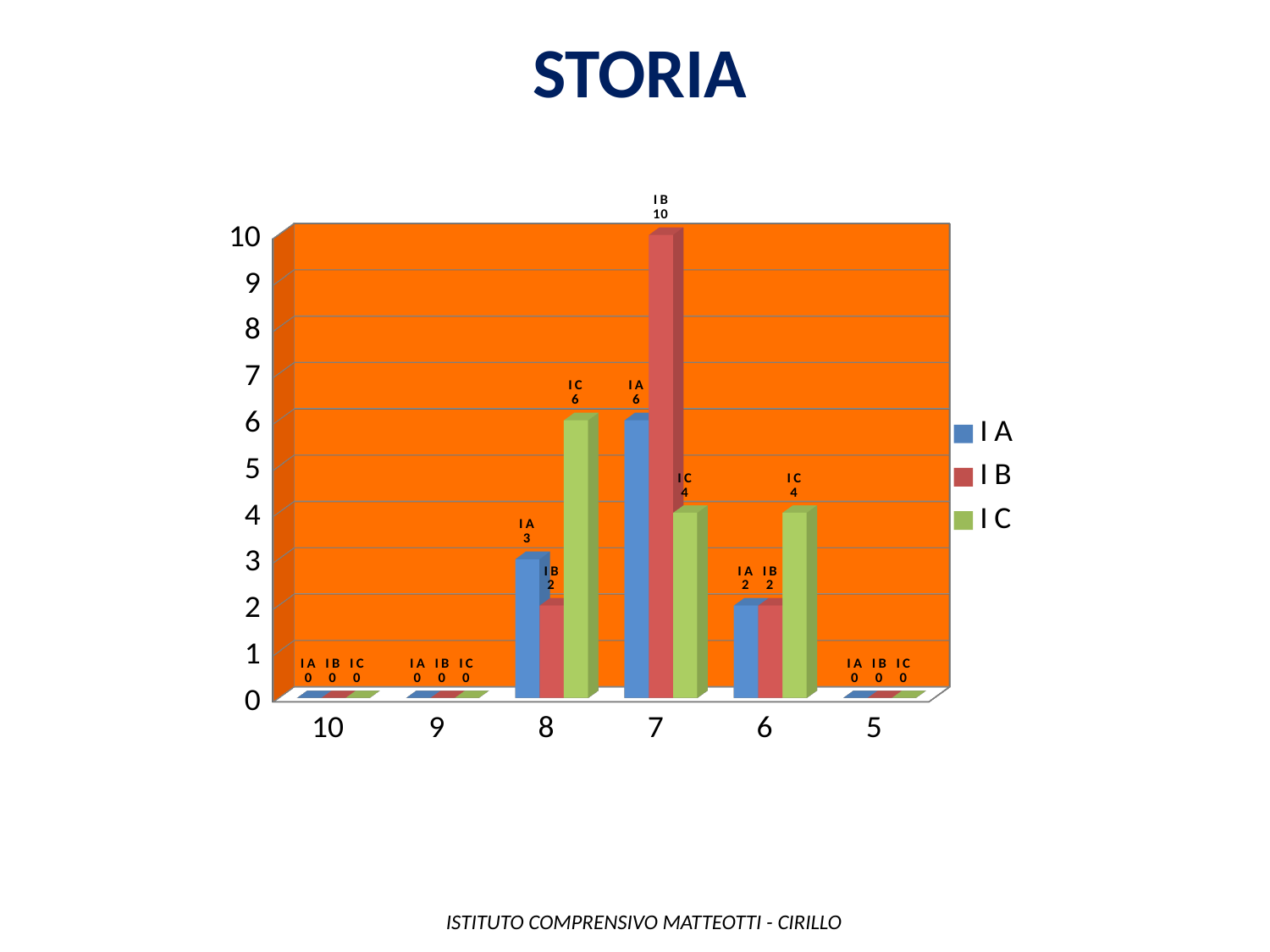
What is the title of the chart? STORIA What kind of chart is shown on the slide? bar chart How many series does the legend list? 3 What is the value for I C at category 8? 6 What is the difference between the I B value and the I A value at category 7? 4 Which series has the lowest value at category 8? I B Which is larger at category 8: the value for I A or the value for I C? I C Which series has the highest value at category 7? I B How many categories are shown on the x axis? 6 What is the value for I B at category 8? 2 What is the value for I B at category 7? 10 What is the value for I A at category 6? 2